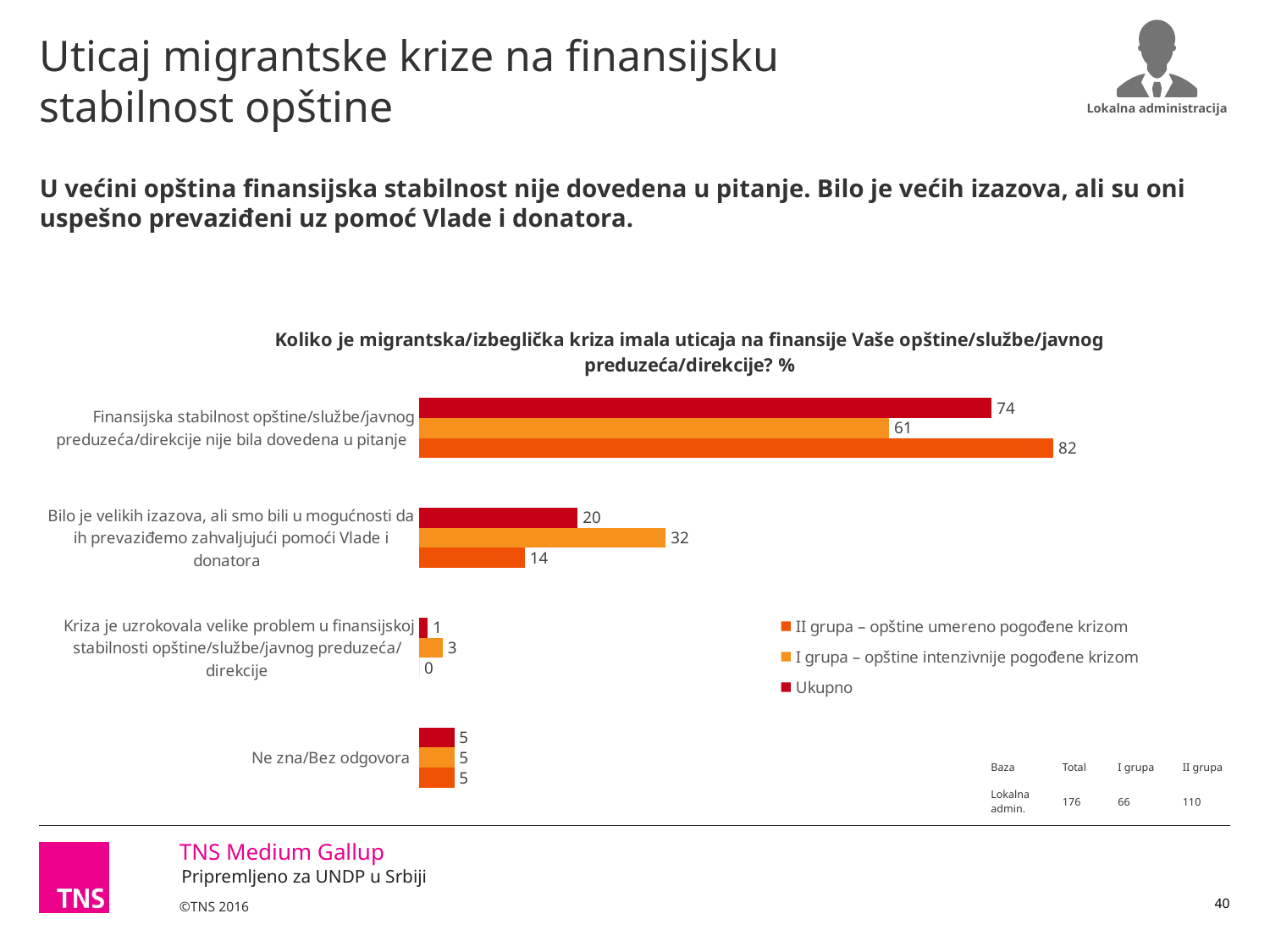
For "Bilo je velikih izazova, ali smo bili u mogućnosti da ih prevaziđemo zahvaljujući pomoći Vlade i donatora", which is larger: the I grupa value or the II grupa value? I grupa How many categories are shown on the chart? 4 What is the value for "II grupa – opštine umereno pogođene krizom" in the category "Finansijska stabilnost opštine/službe/javnog preduzeća/direkcije nije bila dovedena u pitanje"? 82 What is the Ukupno value for "Finansijska stabilnost opštine/službe/javnog preduzeća/direkcije nije bila dovedena u pitanje"? 74 What is the difference between the II grupa and I grupa values for "Finansijska stabilnost opštine/službe/javnog preduzeća/direkcije nije bila dovedena u pitanje"? 21 How many series does the legend list? 3 Which category has the highest Ukupno value? Finansijska stabilnost opštine/službe/javnog preduzeća/direkcije nije bila dovedena u pitanje What is the II grupa value for "Kriza je uzrokovala velike problem u finansijskoj stabilnosti opštine/službe/javnog preduzeća/direkcije"? 0 What is the value for "I grupa – opštine intenzivnije pogođene krizom" in the category "Bilo je velikih izazova, ali smo bili u mogućnosti da ih prevaziđemo zahvaljujući pomoći Vlade i donatora"? 32 What is the Ukupno value for "Ne zna/Bez odgovora"? 5 Which category has the lowest Ukupno value? Kriza je uzrokovala velike problem u finansijskoj stabilnosti opštine/službe/javnog preduzeća/direkcije What kind of chart is shown on the slide? bar chart